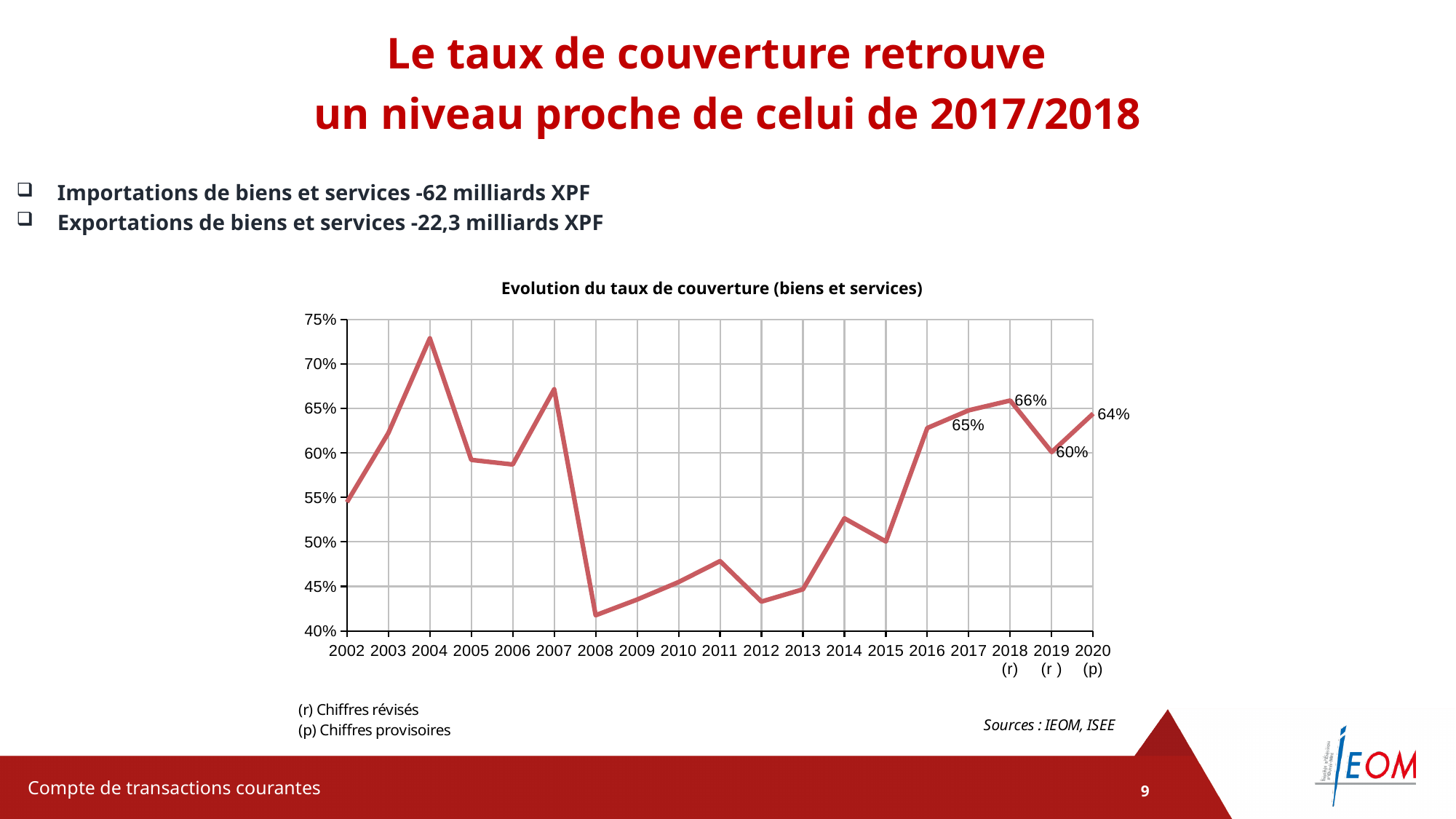
Is the value for 2008 greater or less than 45%? less What is the value for 2019 (r) on the chart? 60% What kind of chart is shown on the slide? Line chart Is the value for 2004 greater or less than 70%? greater Which year has the lowest value on the chart? 2008 How many years are plotted on the x axis? 19 What is the value for 2020 (p) on the chart? 64% What is the difference between the values for 2018 and 2019? 6 percentage points Which year has the highest value on the chart? 2004 What is the value for 2018 (r) on the chart? 66% Which year has the larger value, 2019 or 2020? 2020 What is the value for 2017 on the chart? 65%